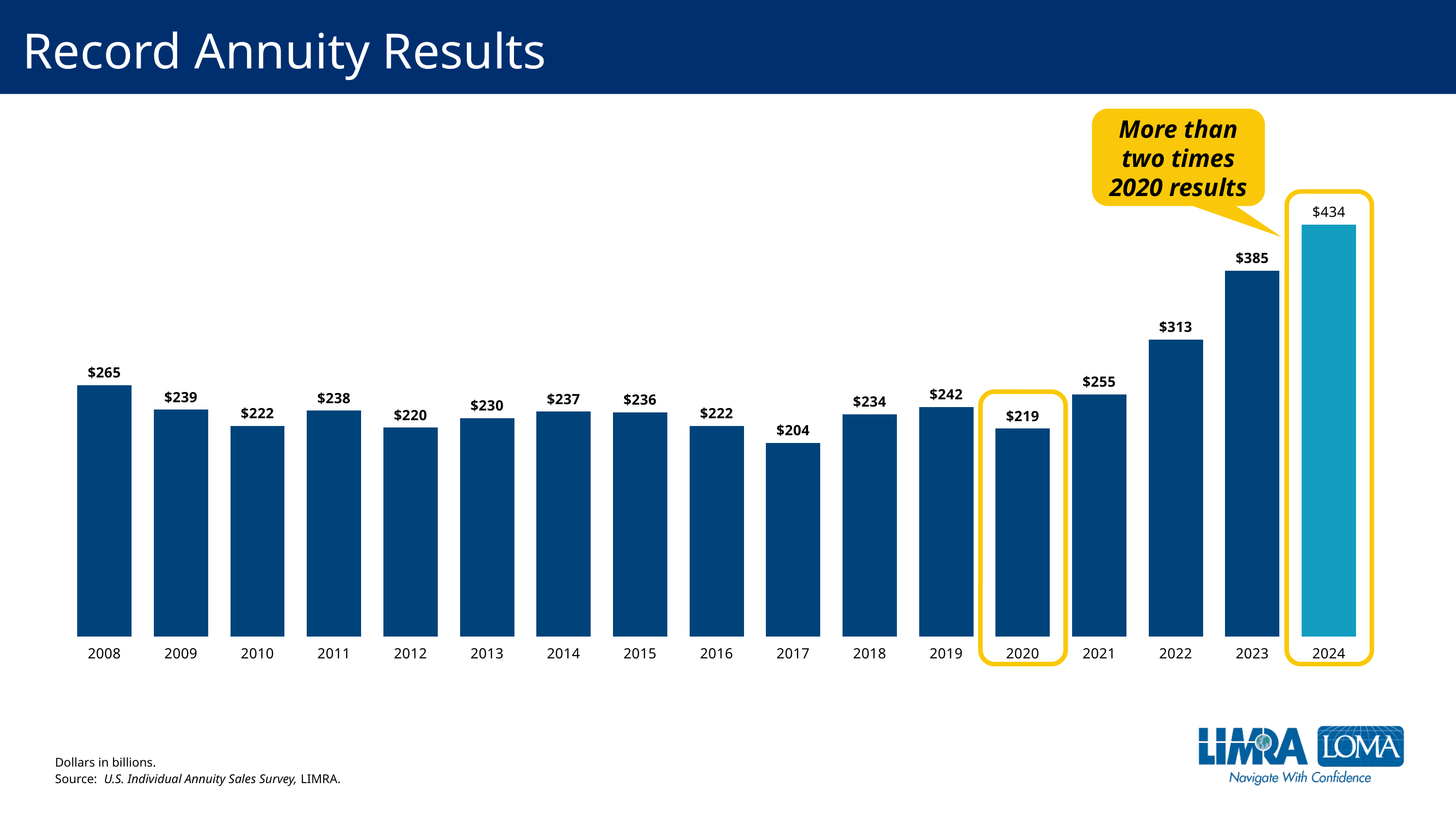
What is the title of the slide? Record Annuity Results What is the value for 2024? $434 How many years are shown on the x axis? 17 Which is larger, the value for 2009 or the value for 2011? 2009 What is the value for 2020? $219 What kind of chart is shown on the slide? bar chart What is the difference between the values for 2024 and 2020? $215 Which year has the lowest value? 2017 Do the values rise or fall from 2020 to 2024? rise Which year has the highest value? 2024 What is the value for 2008? $265 What is the difference between the values for 2024 and 2023? $49